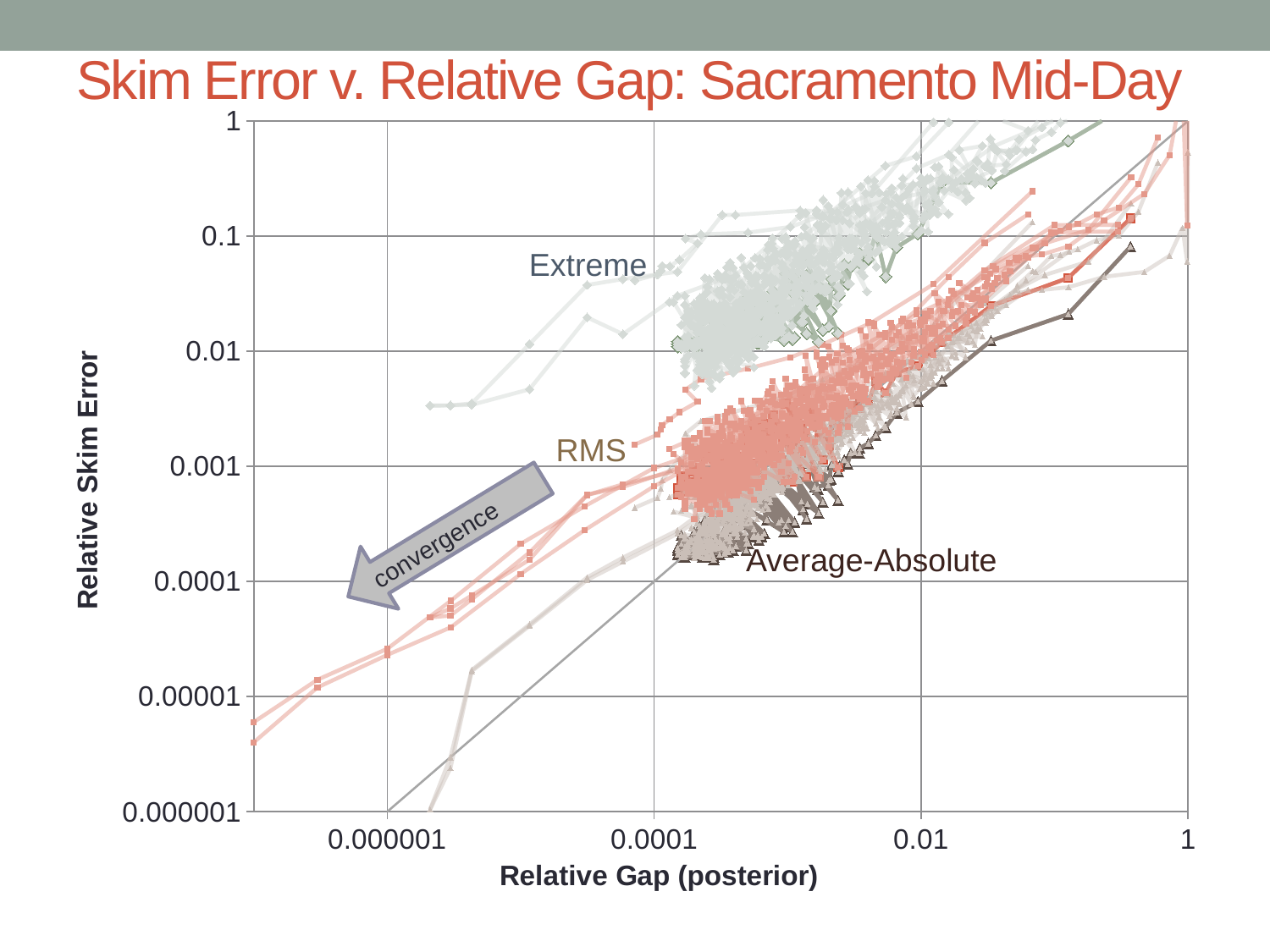
What is the title of the chart? Skim Error v. Relative Gap: Sacramento Mid-Day As the relative gap increases along the x axis, does the relative skim error generally rise or fall? rise At a relative gap of 0.0001, is the relative skim error for the Average-Absolute series greater or less than 0.001? less Which of the three labelled series has the lowest relative skim error at a given relative gap? Average-Absolute At a given relative gap, which series shows the higher relative skim error, Extreme or Average-Absolute? Extreme What kind of chart is shown on the slide? scatter chart At a relative gap of 0.01, is the relative skim error for the RMS series greater or less than 0.1? less How many data series are labelled on the chart? 3 What text is written on the arrow pointing toward the lower left of the chart? convergence At a relative gap of 0.0001, is the relative skim error for the Extreme series greater or less than 0.001? greater Which of the three labelled series has the highest relative skim error at a given relative gap? Extreme